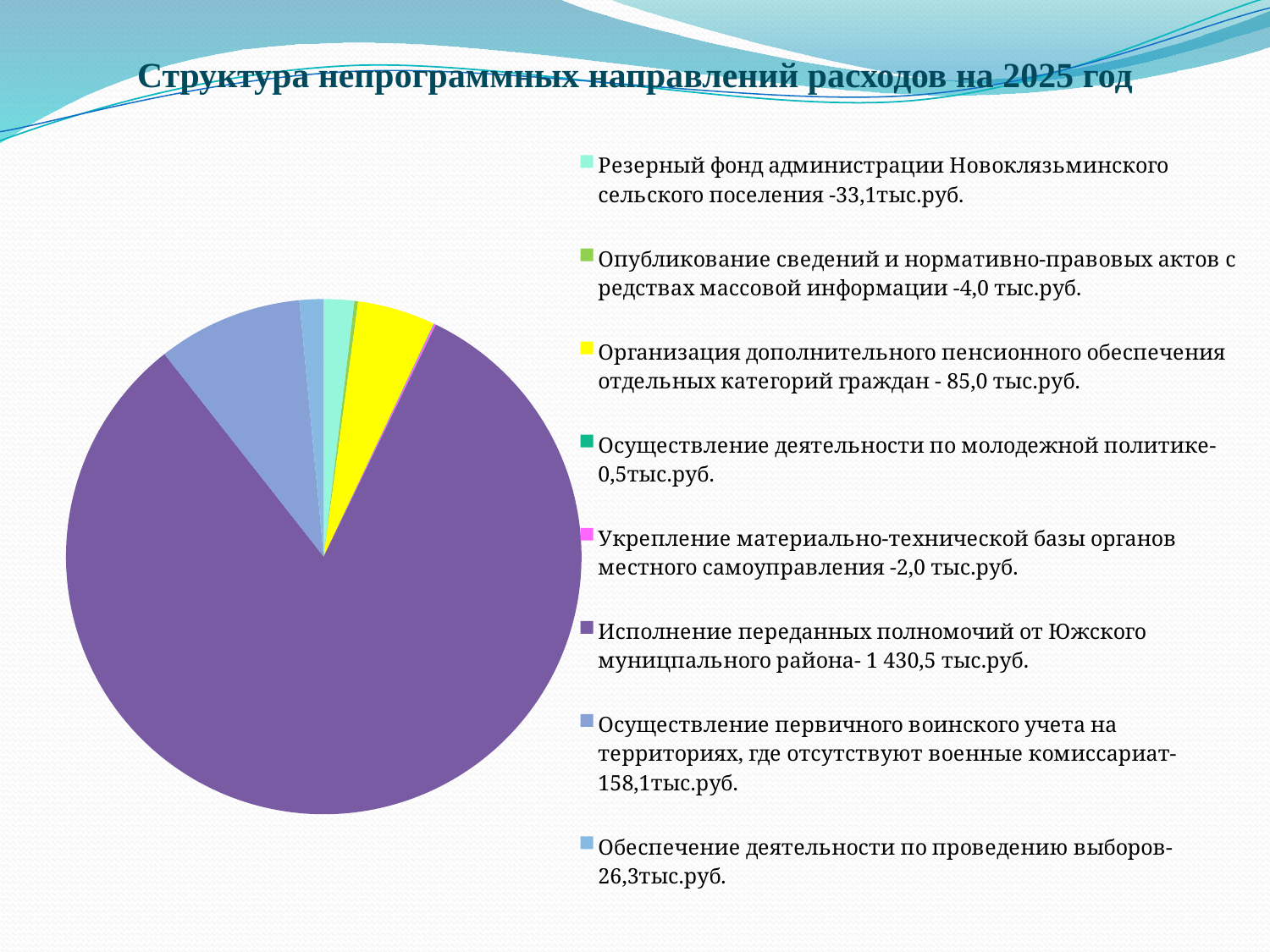
Which category has the smallest value? Осуществление деятельности по молодежной политике What is the title of the chart on the slide? Структура непрограммных направлений расходов на 2025 год What is the difference between the value for 'Осуществление первичного воинского учета' (158,1) and 'Организация дополнительного пенсионного обеспечения' (85,0)? 73,1 тыс.руб. Which is larger: the value for 'Резервный фонд администрации Новоклязьминского сельского поселения' or for 'Обеспечение деятельности по проведению выборов'? Резервный фонд администрации Новоклязьминского сельского поселения What is the value for 'Исполнение переданных полномочий от Южского муниципального района'? 1 430,5 тыс.руб. Which category has the largest share of the pie? Исполнение переданных полномочий от Южского муниципального района How many categories does the pie chart's legend list? 8 What is the value for 'Осуществление деятельности по молодежной политике'? 0,5 тыс.руб. What is the value for 'Осуществление первичного воинского учета на территориях, где отсутствуют военные комиссариаты'? 158,1 тыс.руб. What kind of chart is shown on the slide? pie chart What colour is the slice for 'Организация дополнительного пенсионного обеспечения отдельных категорий граждан'? yellow What is the value for 'Организация дополнительного пенсионного обеспечения отдельных категорий граждан'? 85,0 тыс.руб.